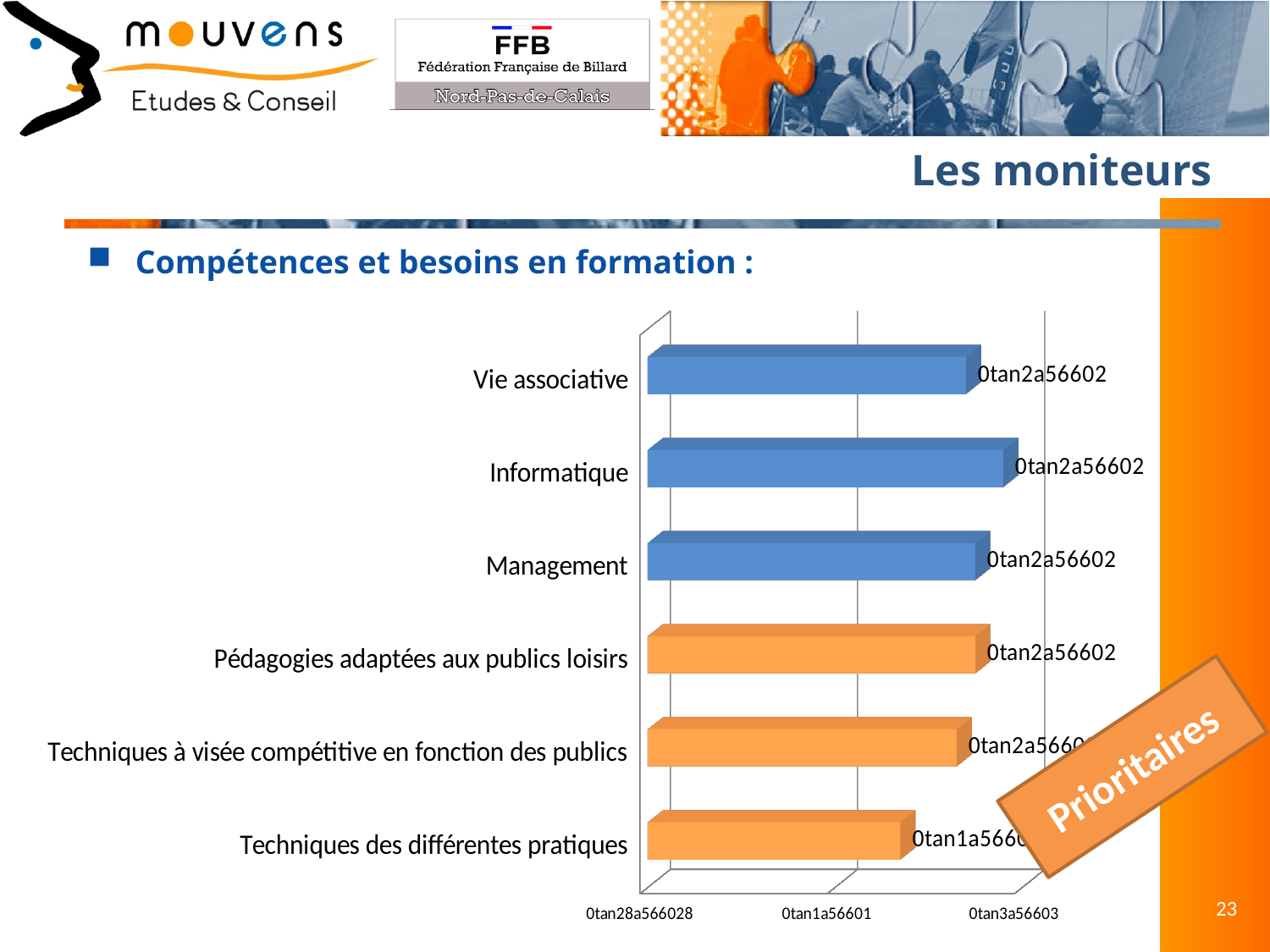
How many categories (bars) does the chart show? 6 Which category has the longest bar in the chart? Informatique What kind of chart is shown on the slide? bar chart What is the category label of the topmost bar in the chart? Vie associative Which bar is longer: Informatique or Techniques des différentes pratiques? Informatique How many bars in the chart are coloured orange? 3 Which bar is longer: Pédagogies adaptées aux publics loisirs or Techniques des différentes pratiques? Pédagogies adaptées aux publics loisirs Which category has the shortest bar in the chart? Techniques des différentes pratiques Which bar is longer: Informatique or Techniques à visée compétitive en fonction des publics? Informatique